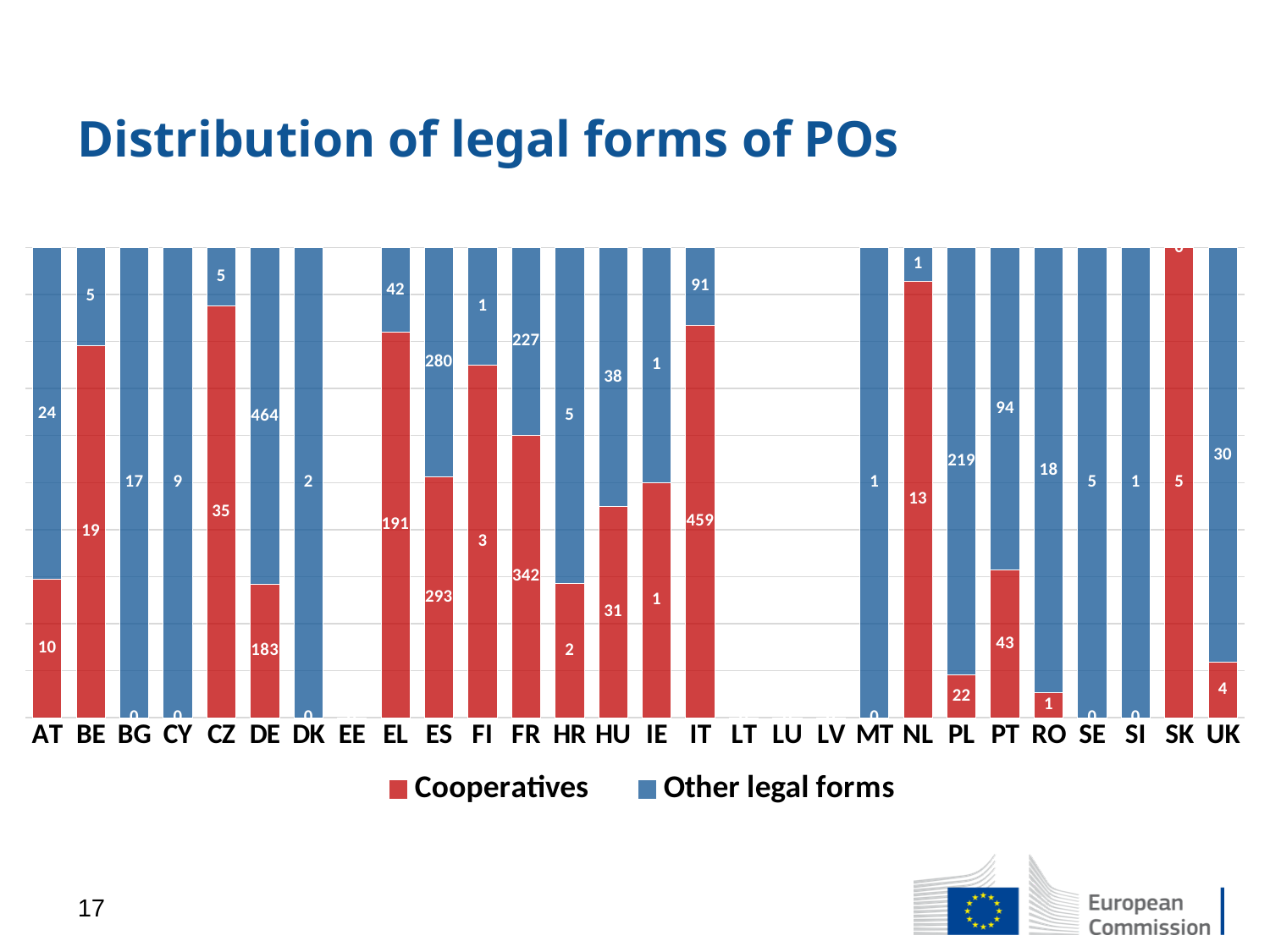
What is the total of the two series for ES? 573 Which country has the highest Cooperatives value? IT What is the Other legal forms value for DE? 464 What kind of chart is shown on the slide? Stacked bar chart What is the Cooperatives value for FR? 342 Which country has the highest Other legal forms value? DE What is the Other legal forms value for PL? 219 What is the title of the chart? Distribution of legal forms of POs How many series does the legend list? 2 Which is larger for HU, the Cooperatives value or the Other legal forms value? Other legal forms What is the difference between the Cooperatives and Other legal forms values for EL? 149 What is the Cooperatives value for IT? 459